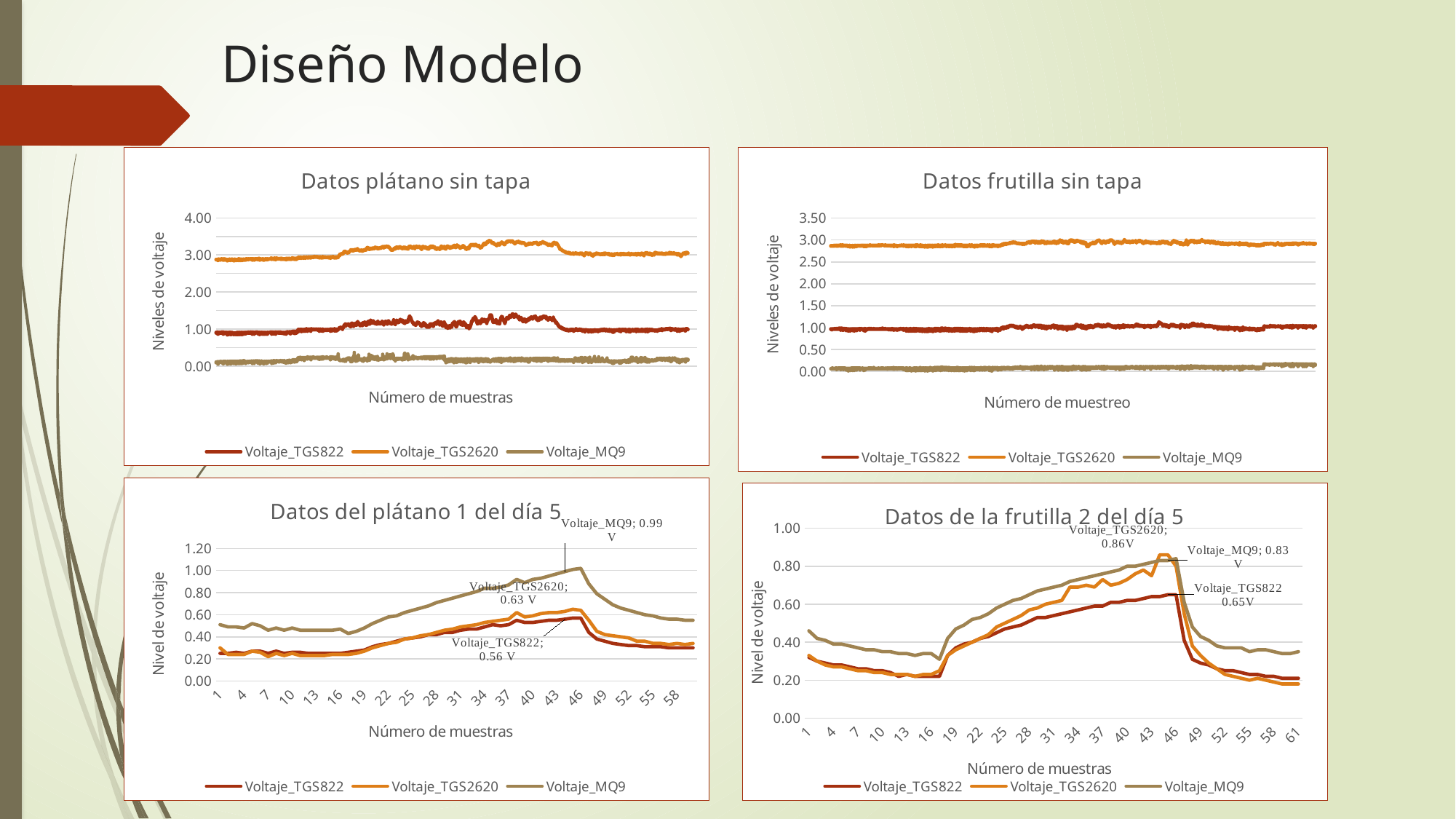
In "Datos de la frutilla 2 del día 5", what is the difference between the labelled peak values of Voltaje_TGS2620 and Voltaje_TGS822? 0.21 V In "Datos de la frutilla 2 del día 5", which series has the highest labelled peak value? Voltaje_TGS2620 In "Datos del plátano 1 del día 5", does Voltaje_MQ9 rise or fall between sample 19 and sample 46? Rise In "Datos del plátano 1 del día 5", what is the difference between the labelled peak values of Voltaje_MQ9 and Voltaje_TGS822? 0.43 V In "Datos plátano sin tapa", which series has the highest voltage levels? Voltaje_TGS2620 How many series does the legend of "Datos frutilla sin tapa" list? 3 What kind of chart is "Datos plátano sin tapa"? Line chart In "Datos frutilla sin tapa", which series has the lowest voltage levels? Voltaje_MQ9 In "Datos frutilla sin tapa", is the value of Voltaje_MQ9 greater or less than 0.50? less In "Datos plátano sin tapa", is the value of Voltaje_TGS2620 greater or less than 2.00 across the samples? greater In "Datos de la frutilla 2 del día 5", what peak value is labelled for Voltaje_TGS822? 0.65V In "Datos del plátano 1 del día 5", what peak value is labelled for Voltaje_MQ9? 0.99 V